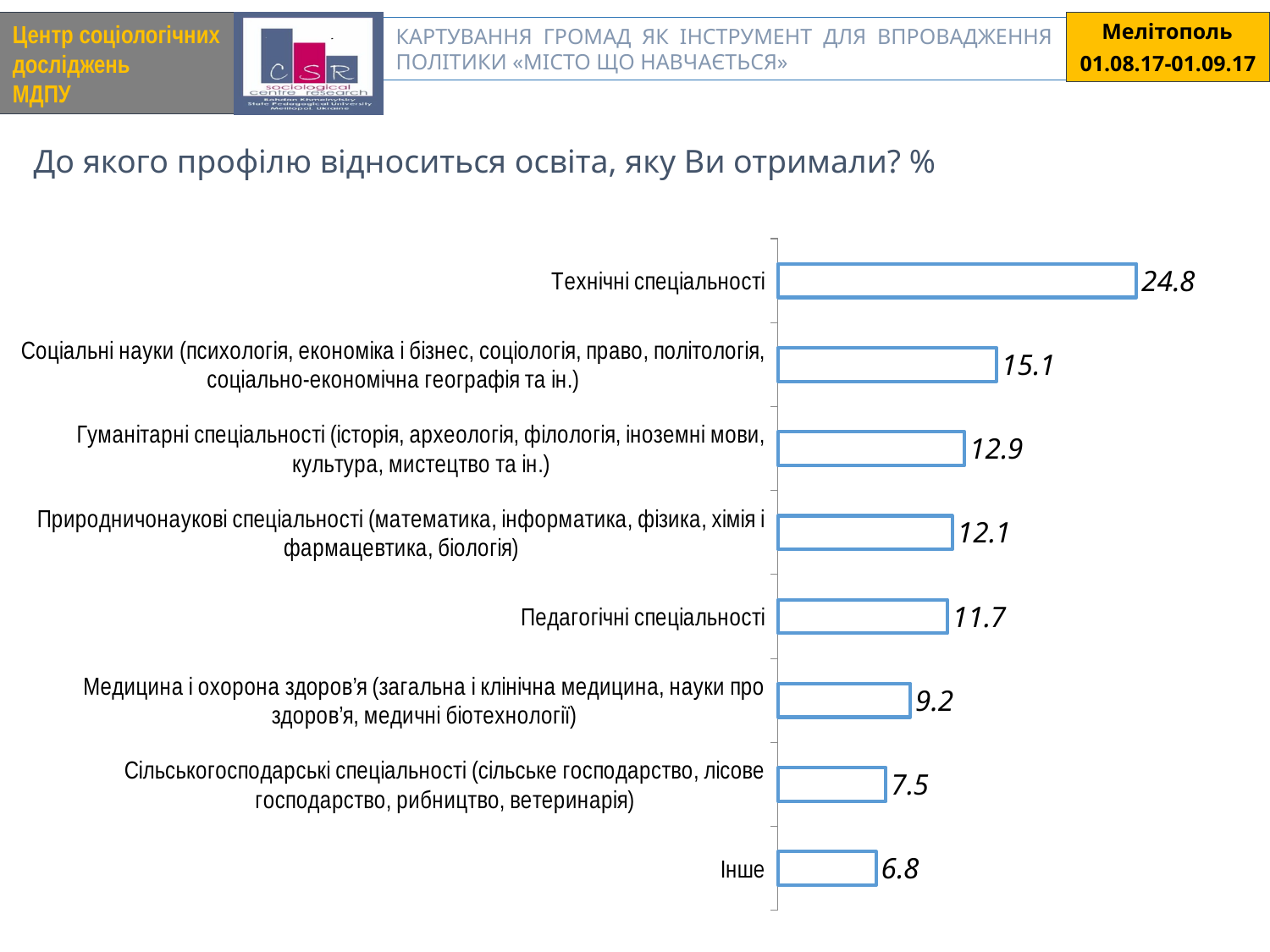
What value is shown for Технічні спеціальності? 24.8 How many categories are shown in the chart? 8 Which category has the lowest value? Інше What is the title of the chart on the slide? До якого профілю відноситься освіта, яку Ви отримали? % What is the difference between the values for Сільськогосподарські спеціальності and Інше? 0.7 What kind of chart is shown on the slide? Bar chart What is the difference between the values for Технічні спеціальності and Соціальні науки? 9.7 What value is shown for Медицина і охорона здоров'я? 9.2 What value is shown for Інше? 6.8 Which category has the highest value? Технічні спеціальності Which is larger, the value for Гуманітарні спеціальності or the value for Природничонаукові спеціальності? Гуманітарні спеціальності What value is shown for Педагогічні спеціальності? 11.7